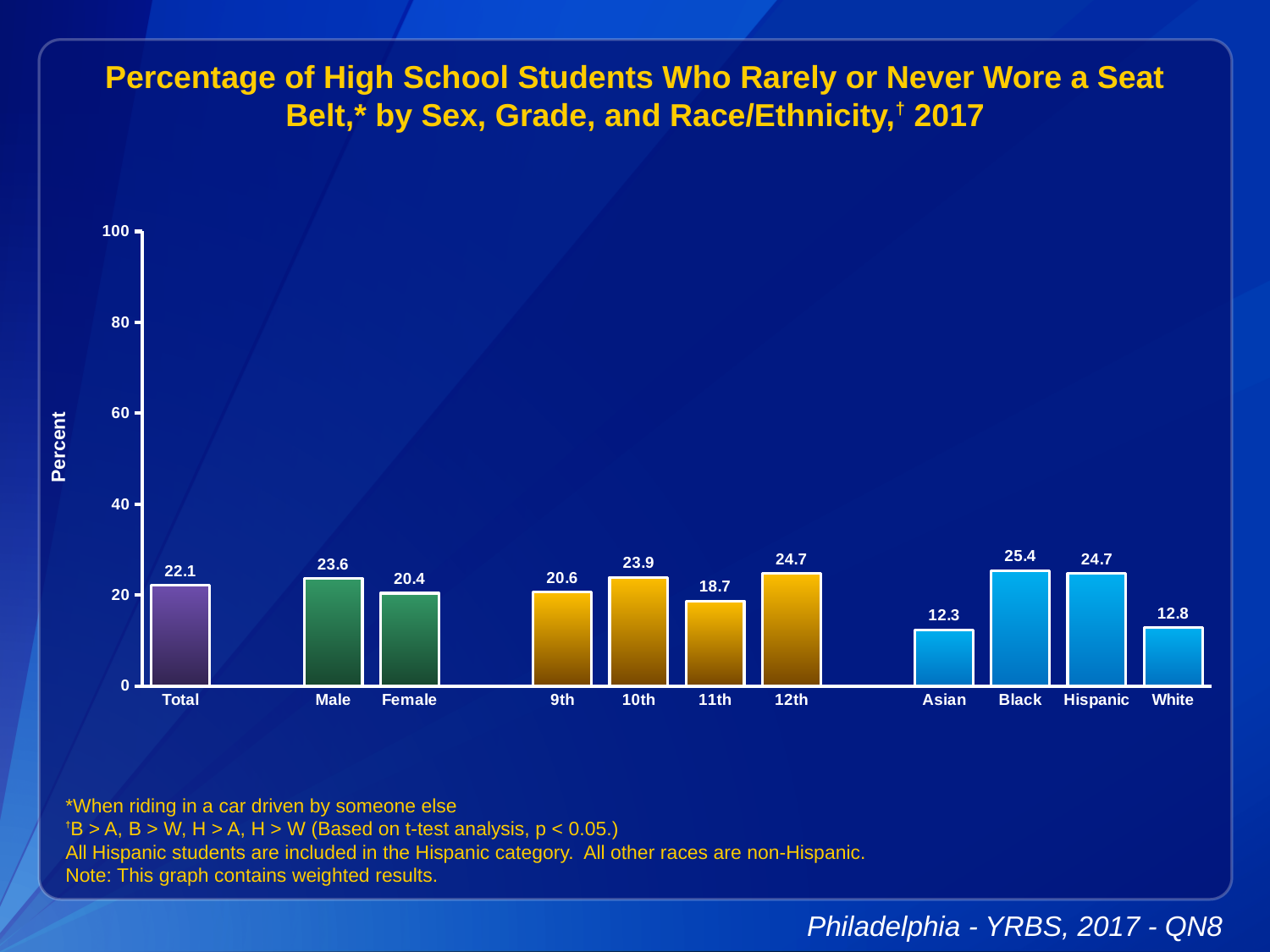
What is the value for Total? 22.1 What is the value for Asian? 12.3 Which category has the lowest value? Asian What is the label on the y axis? Percent How many categories are shown on the x axis? 11 Which is larger, the value for 10th grade or the value for 11th grade? 10th What is the difference between the values for Male and Female? 3.2 What is the difference between the values for 12th grade and 9th grade? 4.1 What is the value for Female? 20.4 Which category has the highest value? Black What kind of chart is this? bar chart What is the value for 11th grade? 18.7